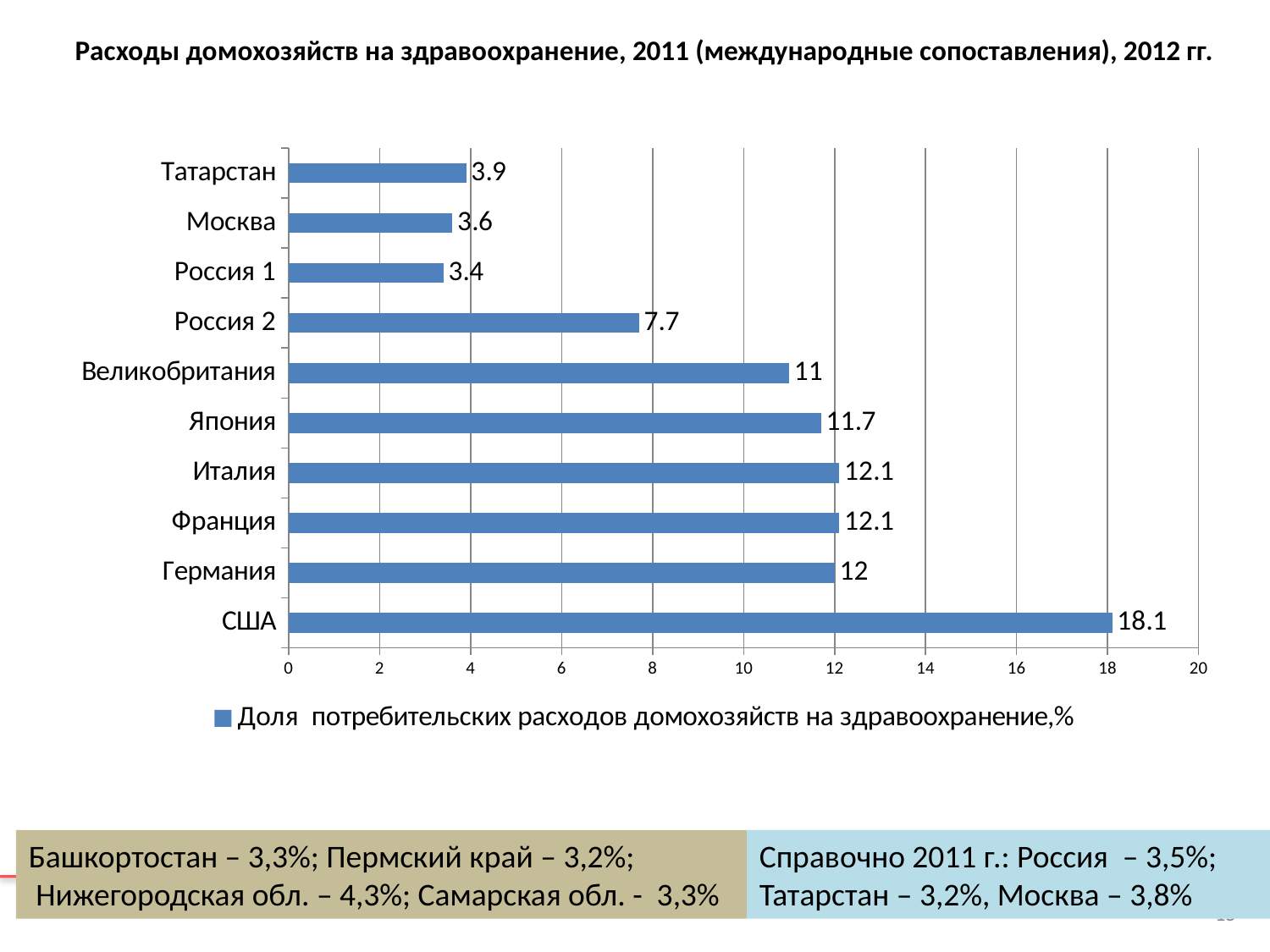
What is the legend entry of the chart? Доля потребительских расходов домохозяйств на здравоохранение,% What is the difference between the values for США and Германия? 6.1 What kind of chart is shown on the slide? Bar chart How many series does the legend list? 1 How many categories are shown on the chart? 10 What is the difference between the values for Татарстан and Москва? 0.3 What is the value for США (USA)? 18.1 What is the value for Россия 2? 7.7 What is the value for Япония (Japan)? 11.7 Which is larger, the value for Великобритания or the value for Россия 2? Великобритания Which category has the lowest value? Россия 1 Which category has the highest value? США